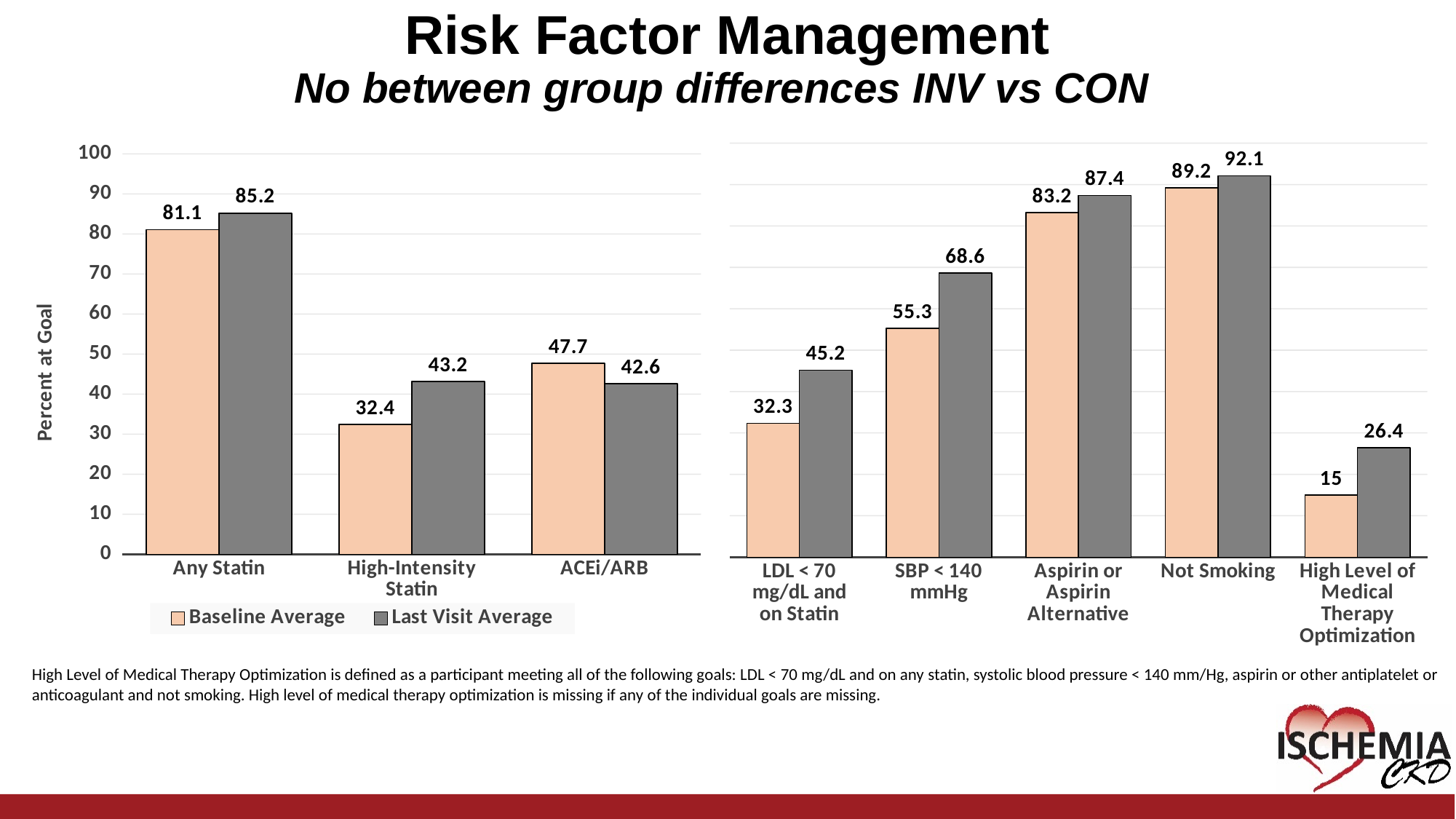
What kind of chart is the left chart? Bar chart In the left chart, what is the Baseline Average value for Any Statin? 81.1 In the right chart, what is the difference between the Last Visit Average and Baseline Average for LDL < 70 mg/dL and on Statin? 12.9 In the left chart, which category has the lowest Baseline Average value? High-Intensity Statin In the right chart, what is the Last Visit Average value for SBP < 140 mmHg? 68.6 In the right chart, what is the Baseline Average value for High Level of Medical Therapy Optimization? 15 How many categories are shown in the right chart? 5 How many series does the legend list? 2 In the left chart, for ACEi/ARB, which is larger: the Baseline Average or the Last Visit Average? Baseline Average In the left chart, what is the difference between the Last Visit Average and Baseline Average for High-Intensity Statin? 10.8 What is the y-axis label of the left chart? Percent at Goal In the right chart, which category has the highest Last Visit Average value? Not Smoking